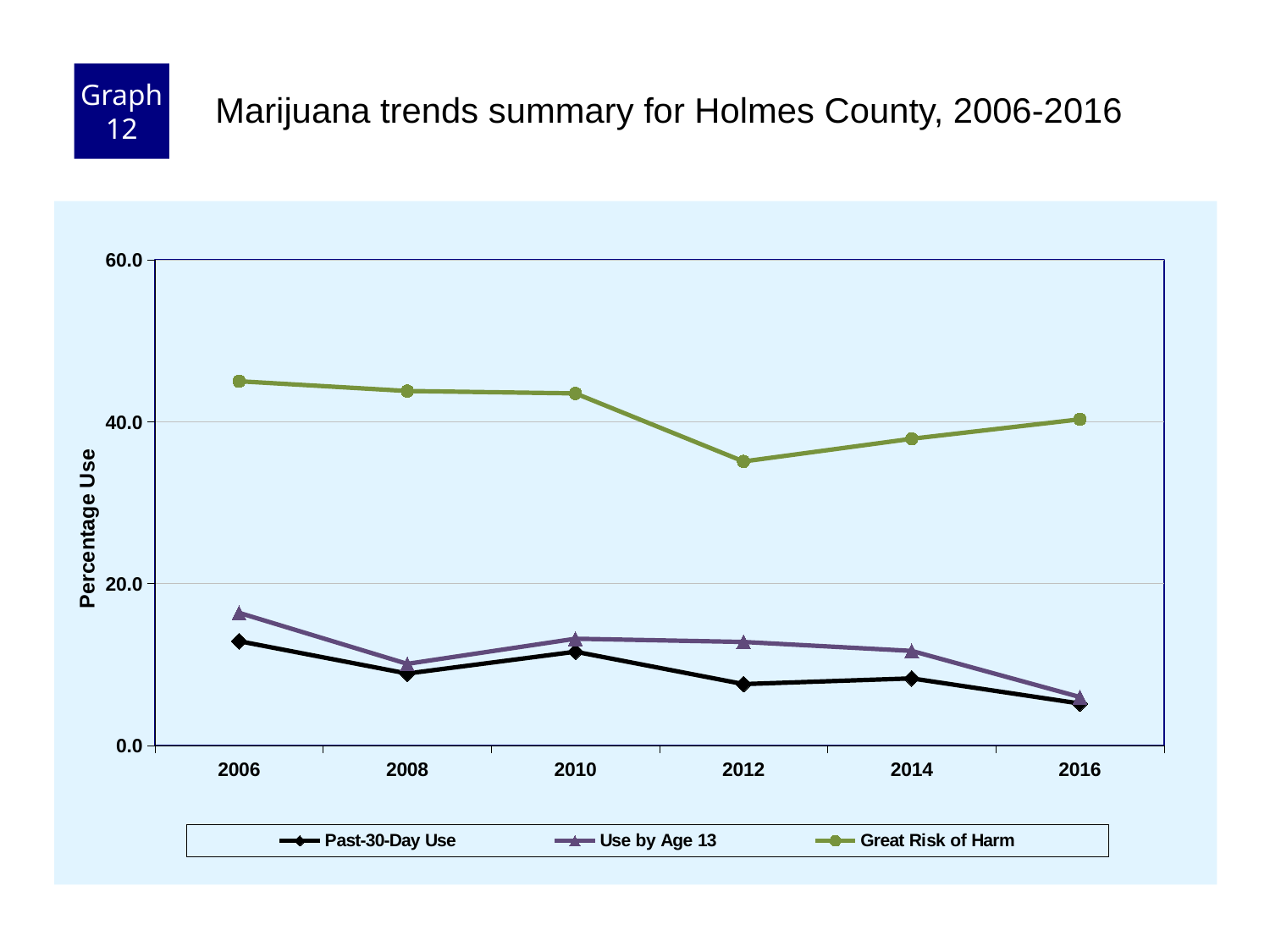
Does Great Risk of Harm rise or fall from 2012 to 2016? Rise Is the value for Use by Age 13 in 2006 greater or less than 20.0? less What kind of chart is shown on the slide? Line chart In which year is Past-30-Day Use at its lowest? 2016 In 2006, which is larger: Use by Age 13 or Past-30-Day Use? Use by Age 13 Is the value for Great Risk of Harm in 2012 greater or less than 40.0? less What is the label on the y axis? Percentage Use How many series does the legend list? 3 In which year is Use by Age 13 at its highest? 2006 How many years are plotted along the x axis? 6 Is the value for Great Risk of Harm in 2006 greater or less than 40.0? greater In which year is Great Risk of Harm at its lowest? 2012